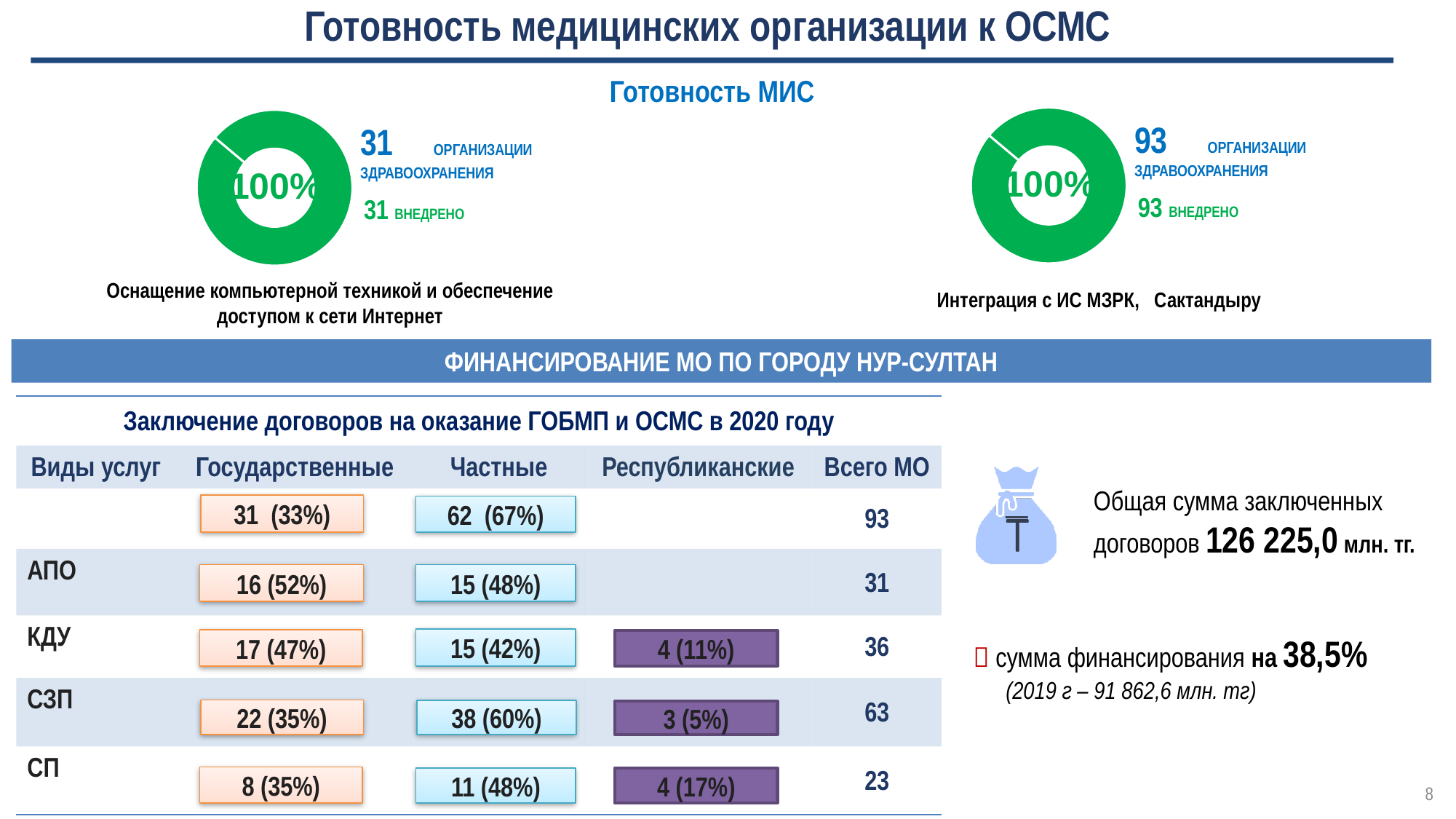
In the left donut chart (Оснащение компьютерной техникой и обеспечение доступом к сети Интернет), what percentage is shown in the centre? 100% In the left donut chart (Оснащение компьютерной техникой), how many organisations are marked as 'внедрено'? 31 What kind of chart is used under the heading 'Готовность МИС' on the left side of the slide? Donut (pie) chart In the right donut chart (Интеграция с ИС МЗРК, Сактандыру), how many organisations are marked as 'внедрено'? 93 How many donut charts are shown under the heading 'Готовность МИС'? 2 In the right donut chart (Интеграция с ИС МЗРК, Сактандыру), how many healthcare organisations are reported? 93 What is the caption below the right donut chart? Интеграция с ИС МЗРК, Сактандыру What is the difference between the number of organisations in the right donut chart (93) and the left donut chart (31)? 62 What colour is the filled ring of the donut charts under 'Готовность МИС'? Green In the right donut chart (Интеграция с ИС МЗРК, Сактандыру), what percentage is shown in the centre? 100% In the left donut chart (Оснащение компьютерной техникой), how many healthcare organisations (организации здравоохранения) are reported? 31 Which donut chart reports more healthcare organisations: the left one (Оснащение компьютерной техникой) or the right one (Интеграция с ИС МЗРК, Сактандыру)? The right one (Интеграция с ИС МЗРК, Сактандыру)